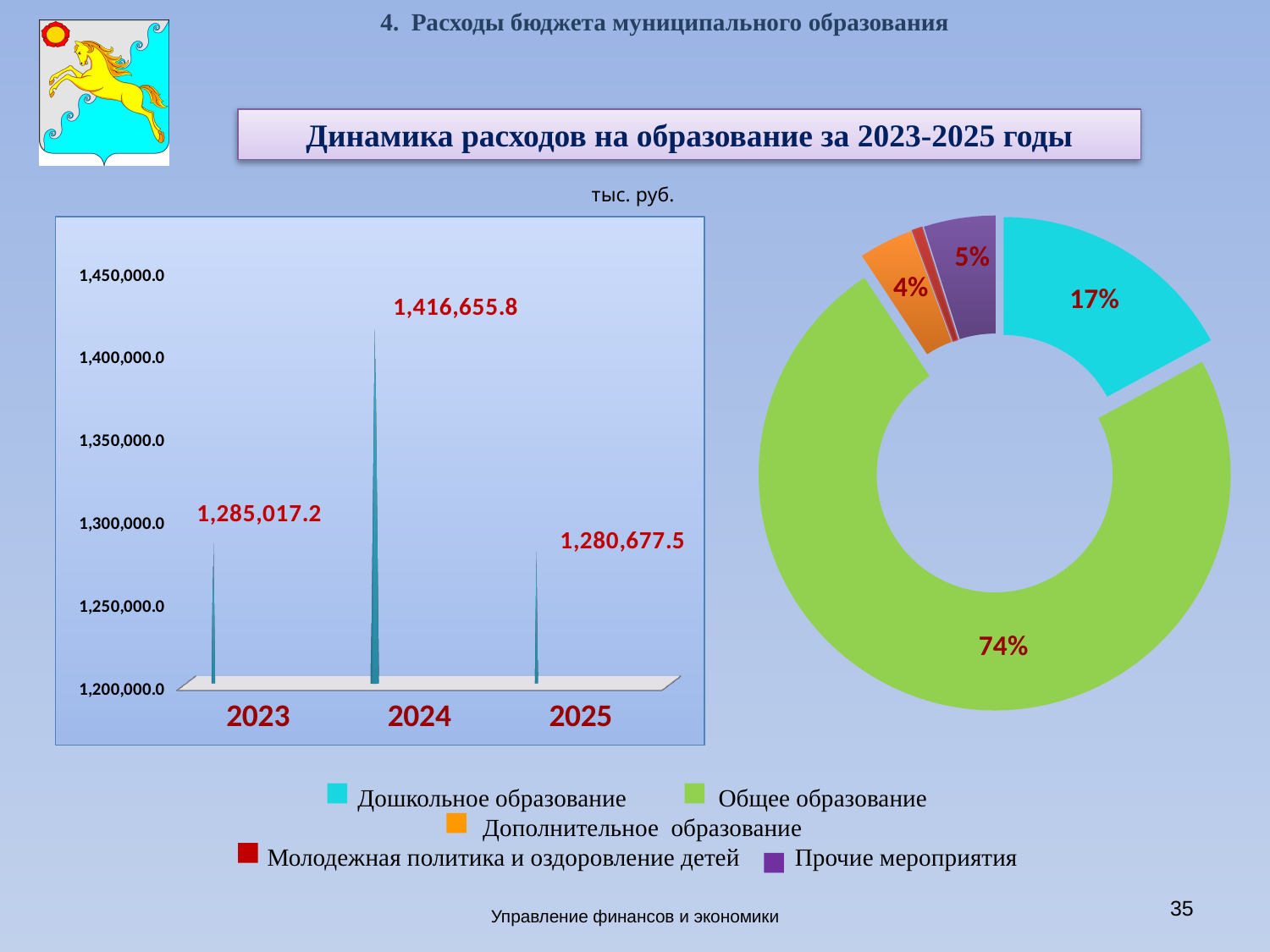
On the right donut chart, what share does Общее образование have? 74% On the left chart (Динамика расходов на образование), what is the value for 2023? 1,285,017.2 On the left chart (Динамика расходов на образование), what is the value for 2025? 1,280,677.5 On the right donut chart, which category has the largest share? Общее образование On the right donut chart, what share does Дошкольное образование have? 17% On the left chart (Динамика расходов на образование), how many years are shown on the x axis? 3 How many categories does the legend below the charts list? 5 On the left chart (Динамика расходов на образование), what is the value for 2024? 1,416,655.8 On the left chart (Динамика расходов на образование), what kind of chart is it? bar chart On the left chart (Динамика расходов на образование), which year has the highest value? 2024 On the left chart (Динамика расходов на образование), what is the difference between the 2024 and 2023 values? 131,638.6 On the left chart (Динамика расходов на образование), which year has the lowest value? 2025